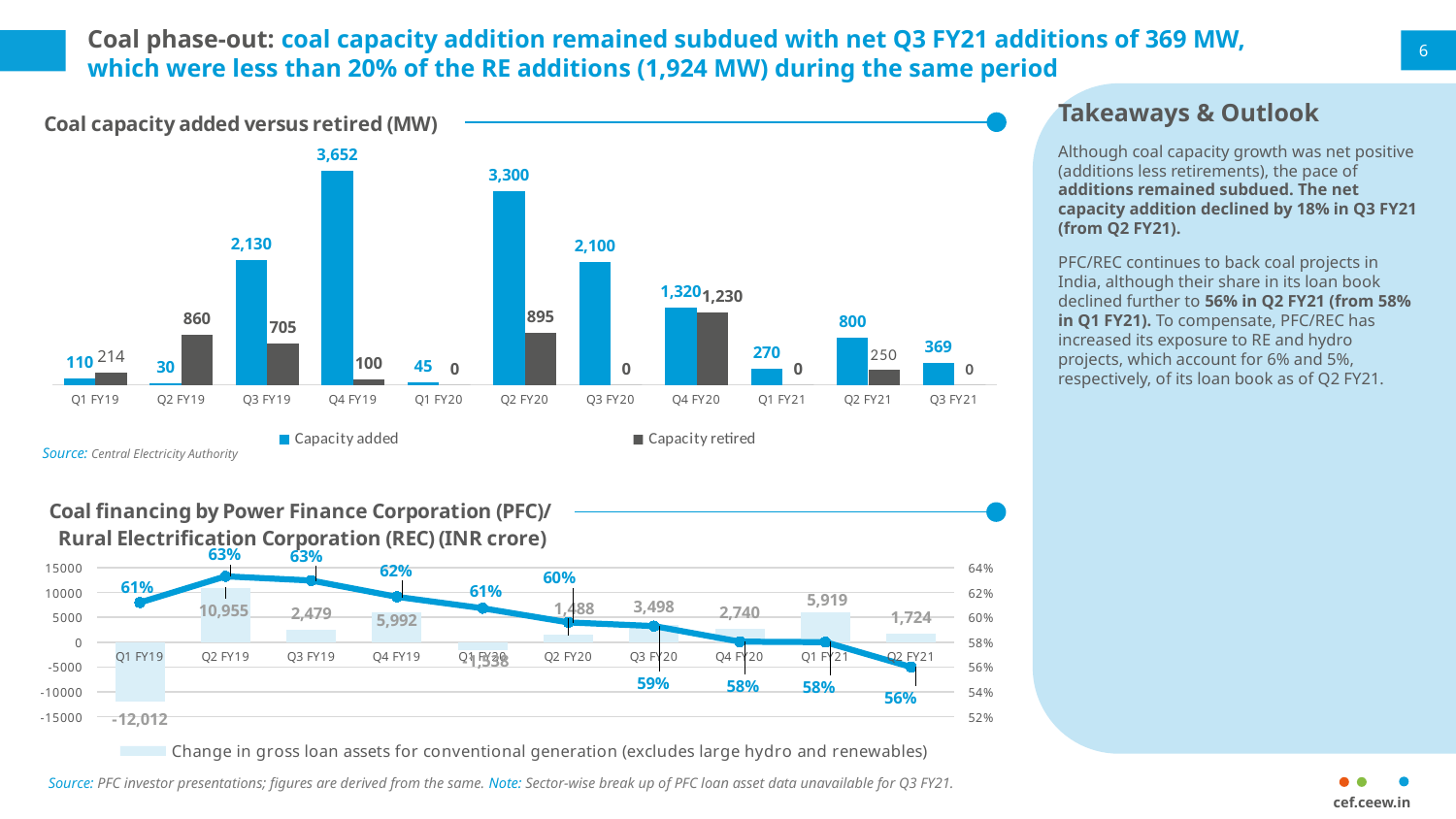
In the 'Coal financing by PFC/REC' chart, what share is shown on the line for Q2 FY21? 56% What type of chart is the 'Coal capacity added versus retired (MW)' chart? Bar chart In the 'Coal financing by PFC/REC' chart, what was the change in gross loan assets for conventional generation in Q2 FY19? 10,955 In the 'Coal financing by PFC/REC' chart, does the line series rise or fall from Q2 FY19 to Q2 FY21? Fall In the 'Coal capacity added versus retired (MW)' chart, what was the coal capacity added in Q4 FY19? 3,652 How many series does the legend of the 'Coal capacity added versus retired (MW)' chart list? 2 In the 'Coal capacity added versus retired (MW)' chart, what is the difference between capacity added and capacity retired in Q4 FY20? 90 In the 'Coal capacity added versus retired (MW)' chart, what was the coal capacity retired in Q2 FY19? 860 How many quarters are shown in the 'Coal capacity added versus retired (MW)' chart? 11 In the 'Coal capacity added versus retired (MW)' chart, was more capacity added or retired in Q2 FY19? Retired In the 'Coal capacity added versus retired (MW)' chart, which quarter had the lowest capacity added? Q2 FY19 In the 'Coal capacity added versus retired (MW)' chart, which quarter had the highest capacity added? Q4 FY19